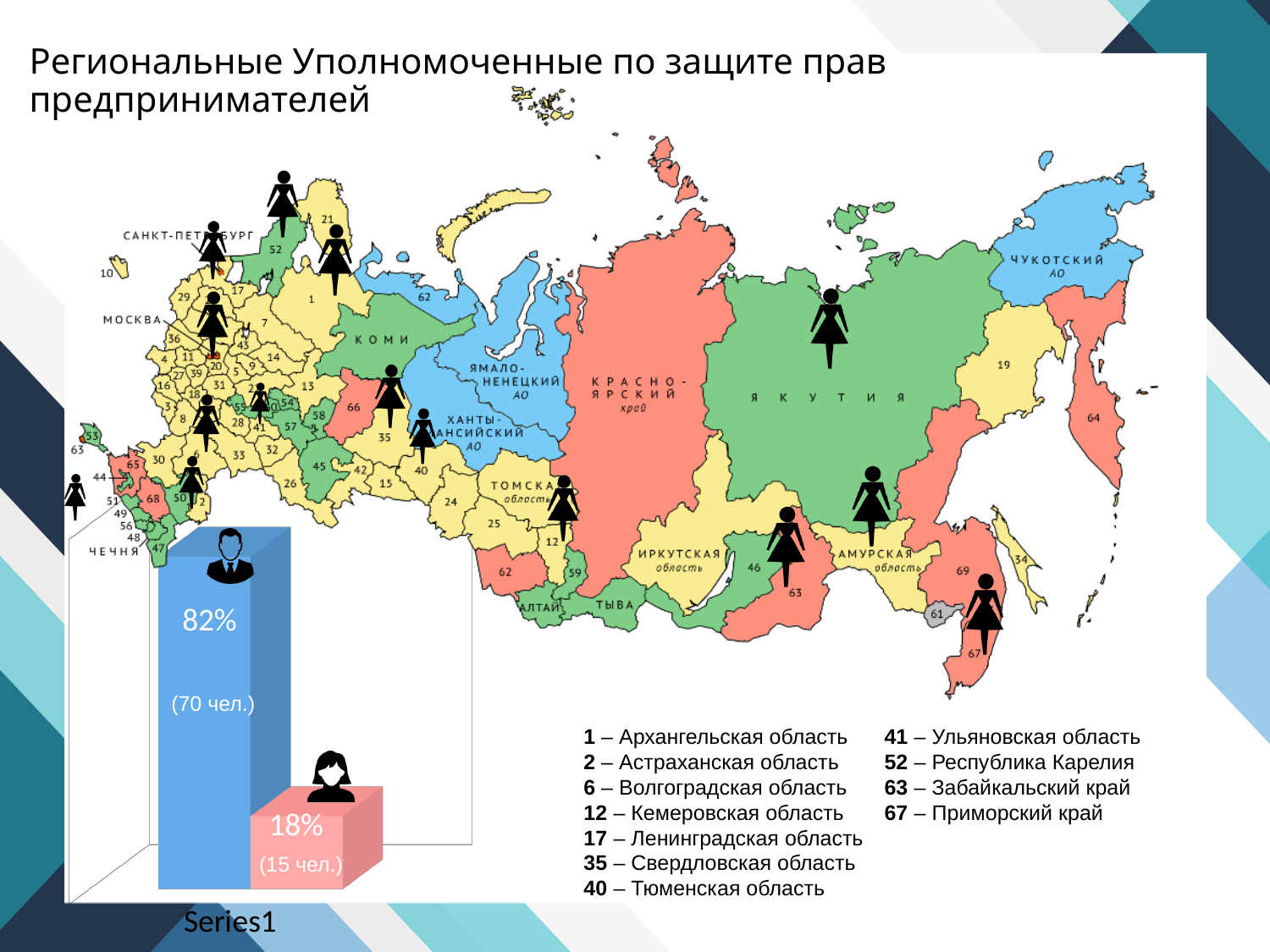
In the bar chart, what is the total number of people represented by the two bars combined? 85 In the bar chart, what colour is the bar showing 18%? pink How many bars does the bar chart contain? 2 What label is printed below the bar chart's horizontal axis? Series1 In the bar chart, which bar is taller, the blue one or the pink one? the blue one In the bar chart, what percentage is shown on the pink bar with the female icon? 18% What kind of chart is shown at the bottom left of the slide? bar chart In the bar chart, how many people does the blue bar (82%) represent, as printed in parentheses? 70 чел. In the bar chart, what is the difference in number of people between the blue bar (70 чел.) and the pink bar (15 чел.)? 55 In the bar chart, how many people does the pink bar (18%) represent, as printed in parentheses? 15 чел. In the bar chart, what is the difference in percentage points between the blue bar and the pink bar? 64 In the bar chart, what percentage is shown on the blue bar with the male icon? 82%